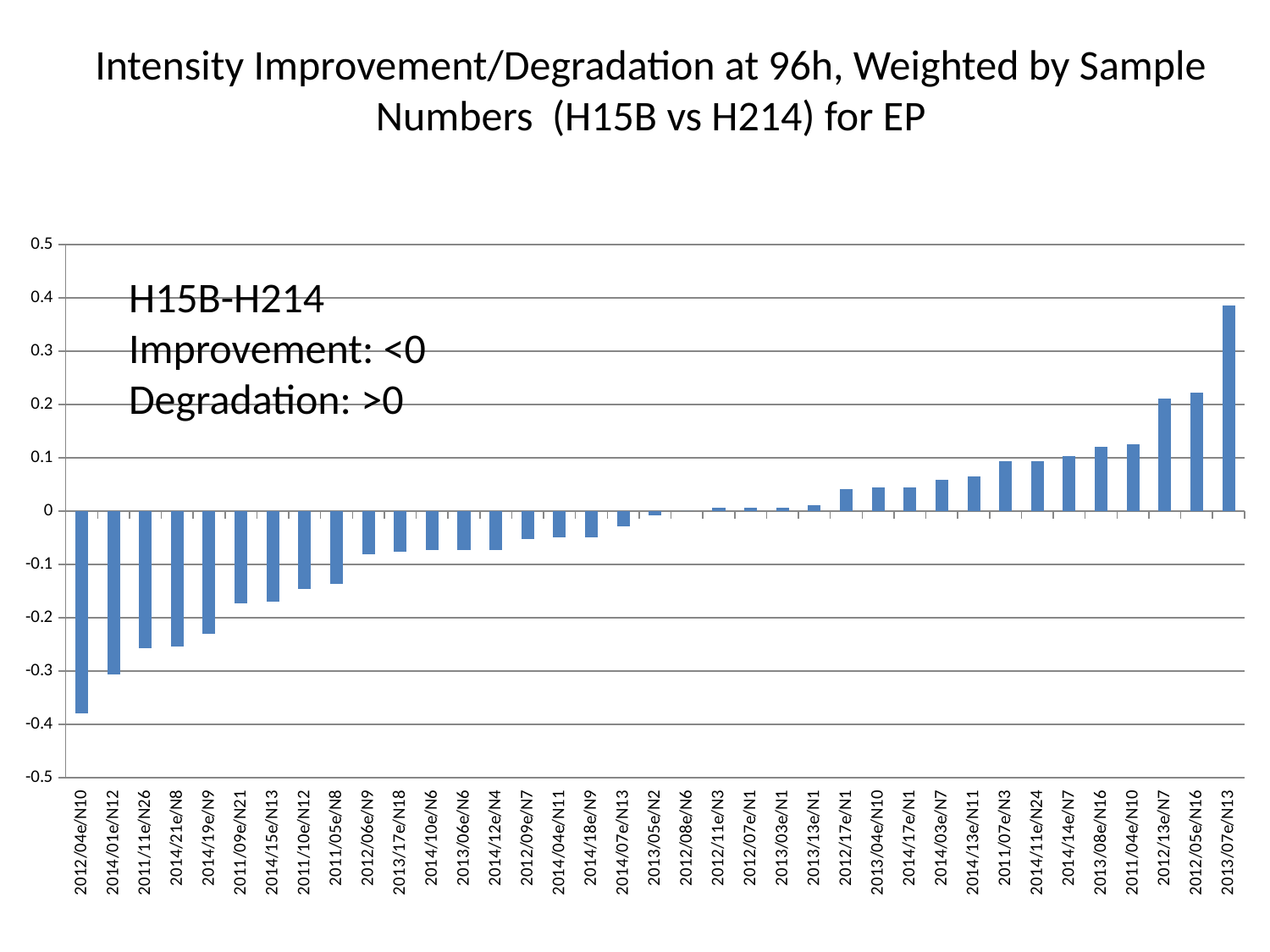
What kind of chart is shown on the slide? bar chart Do the values generally rise or fall moving left to right along the x axis? rise Is the value for 2012/04e/N10 greater or less than -0.3? less Which category has the lowest value? 2012/04e/N10 Which category has the highest value? 2013/07e/N13 Which has the larger value, 2012/05e/N16 or 2013/07e/N13? 2013/07e/N13 Which has the larger value, 2014/19e/N9 or 2011/09e/N21? 2011/09e/N21 Is the value for 2011/09e/N21 greater or less than -0.1? less Is the value for 2014/03e/N7 greater or less than 0.1? less How many categories (bars) are plotted along the x axis? 37 What is the title of the chart? Intensity Improvement/Degradation at 96h, Weighted by Sample Numbers (H15B vs H214) for EP